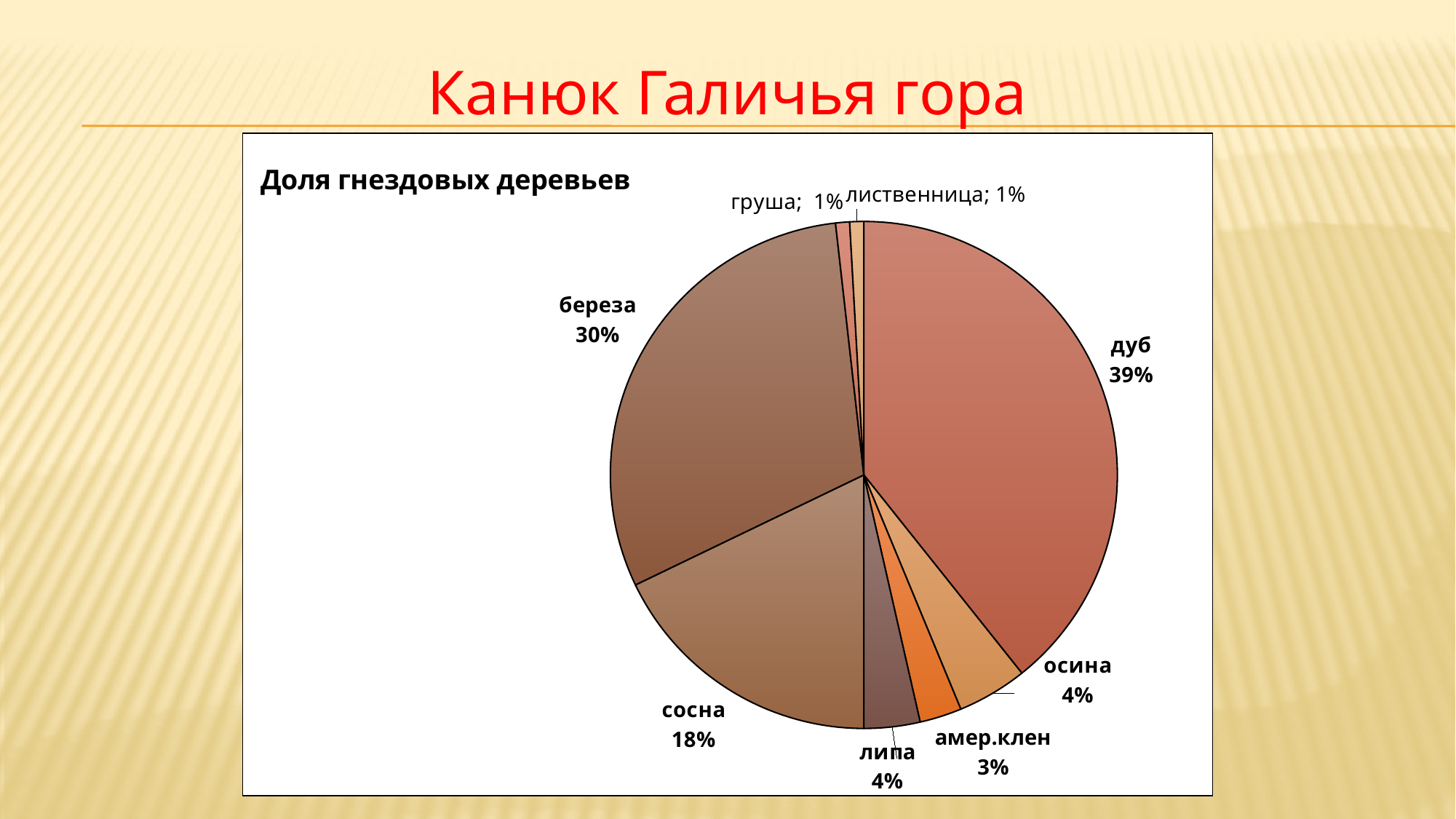
What share of the pie does дуб have? 39% What is the value shown for амер.клен? 3% What share is shown for лиственница? 1% What is the difference between the shares of дуб and береза? 9% How many slices does the pie chart have? 8 What share of the pie does береза have? 30% Which category has the largest slice of the pie? дуб What kind of chart is shown on the slide? pie chart What is the difference between the shares of береза and сосна? 12% What is the title of the chart? Доля гнездовых деревьев Which is larger, the share of сосна or the share of осина? сосна What is the value shown for сосна? 18%